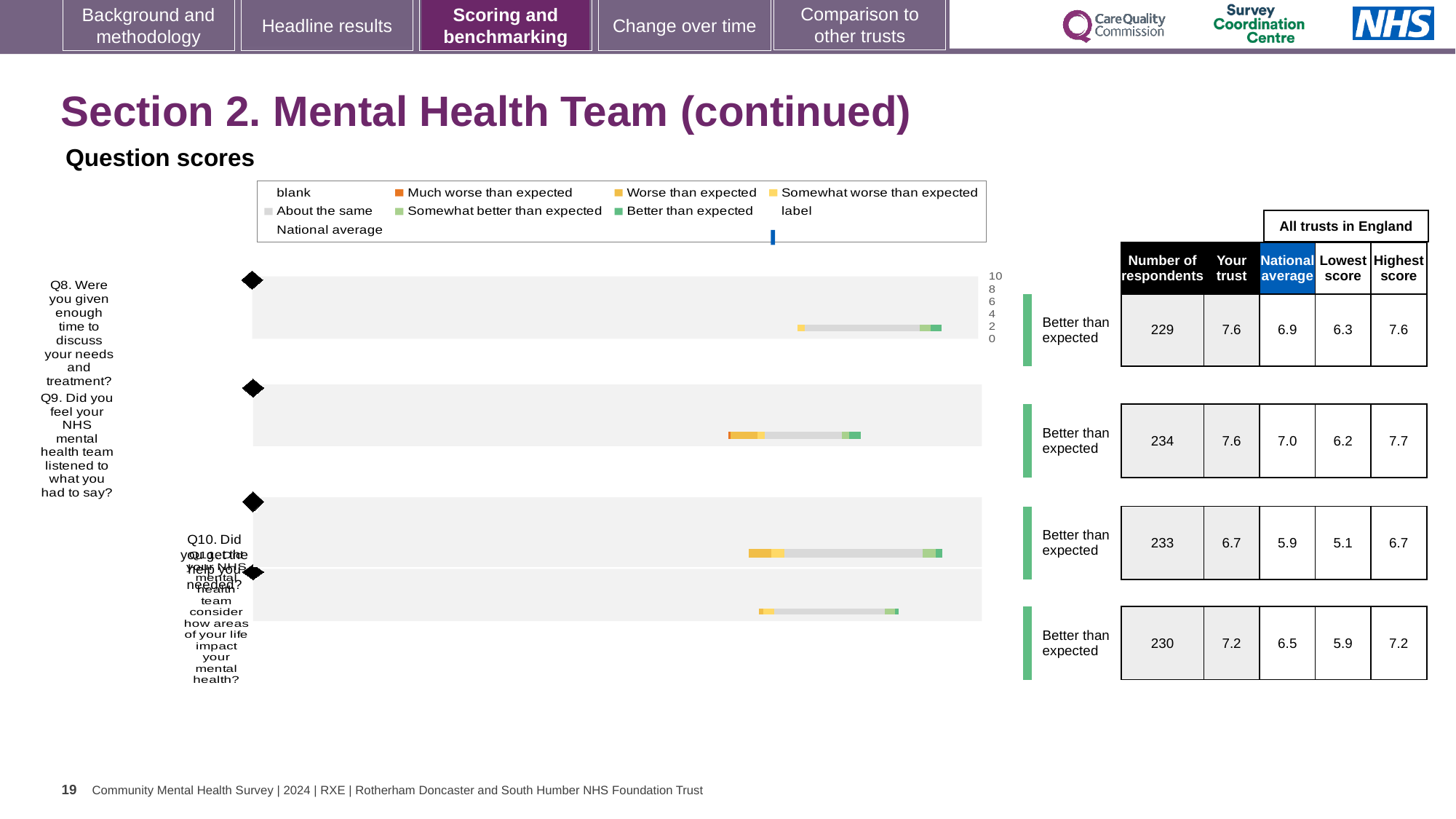
In the table beside the question scores chart, which question has the lowest 'Your trust' score? Q10 In the table beside the question scores chart, how many respondents answered Q11? 230 In the question scores chart, what colour represents 'Much worse than expected' in the legend? orange In the question scores chart, what colour represents 'Better than expected' in the legend? green What kind of chart is used to show the question scores on this slide? bar chart In the table beside the question scores chart, what is the national average for Q10? 5.9 What benchmark label is shown next to the bar for Q8 in the question scores chart? Better than expected In the table beside the question scores chart, is the 'Your trust' score for Q8 larger or smaller than the national average for Q8? larger In the table beside the question scores chart, what is the 'Your trust' score for Q9? 7.6 How many questions (bars) are plotted in the question scores chart? 4 In the table beside the question scores chart, what is the difference between the 'Your trust' score and the national average for Q11? 0.7 In the table beside the question scores chart, which question has the highest number of respondents? Q9